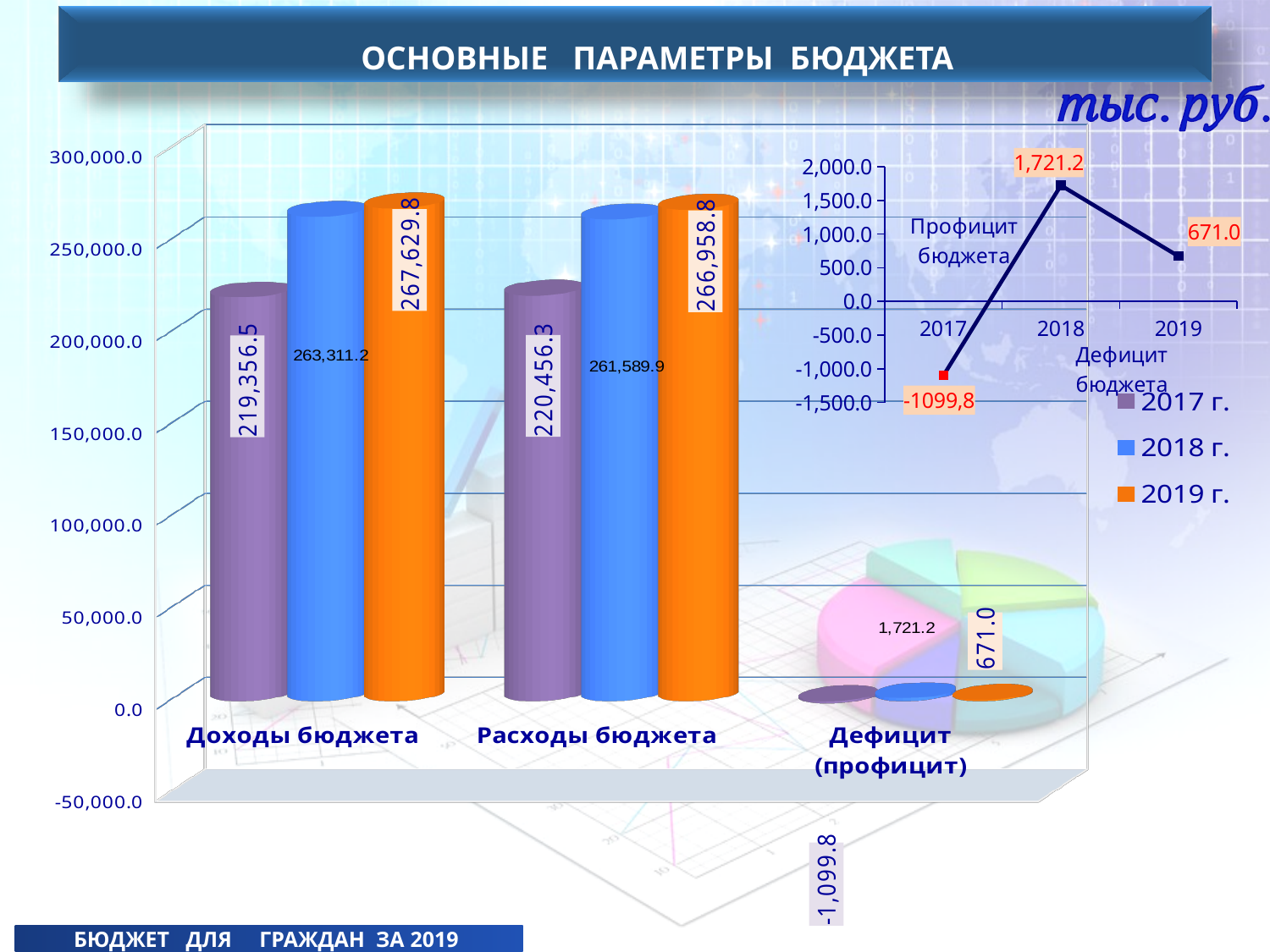
On the large bar chart, which year has the highest value for Расходы бюджета? 2019 г. On the large bar chart, which is larger: Доходы бюджета in 2019 г. or Расходы бюджета in 2019 г.? Доходы бюджета in 2019 г. On the large bar chart, what is the value for Доходы бюджета in 2019 г.? 267,629.8 On the large bar chart, what is the value for Дефицит (профицит) in 2018 г.? 1,721.2 On the large bar chart, what is the value for Расходы бюджета in 2017 г.? 220,456.3 On the large bar chart, what is the value for Доходы бюджета in 2018 г.? 263,311.2 How many series does the legend of the large bar chart list? 3 What type of chart is the small chart in the top right of the slide? Line chart On the large bar chart, what is the difference between Доходы бюджета in 2019 г. and in 2017 г.? 48,273.3 On the small line chart in the top right, what is the value for 2017? -1099,8 How many categories are shown on the x axis of the large bar chart? 3 On the large bar chart, which year has the lowest value for Доходы бюджета? 2017 г.